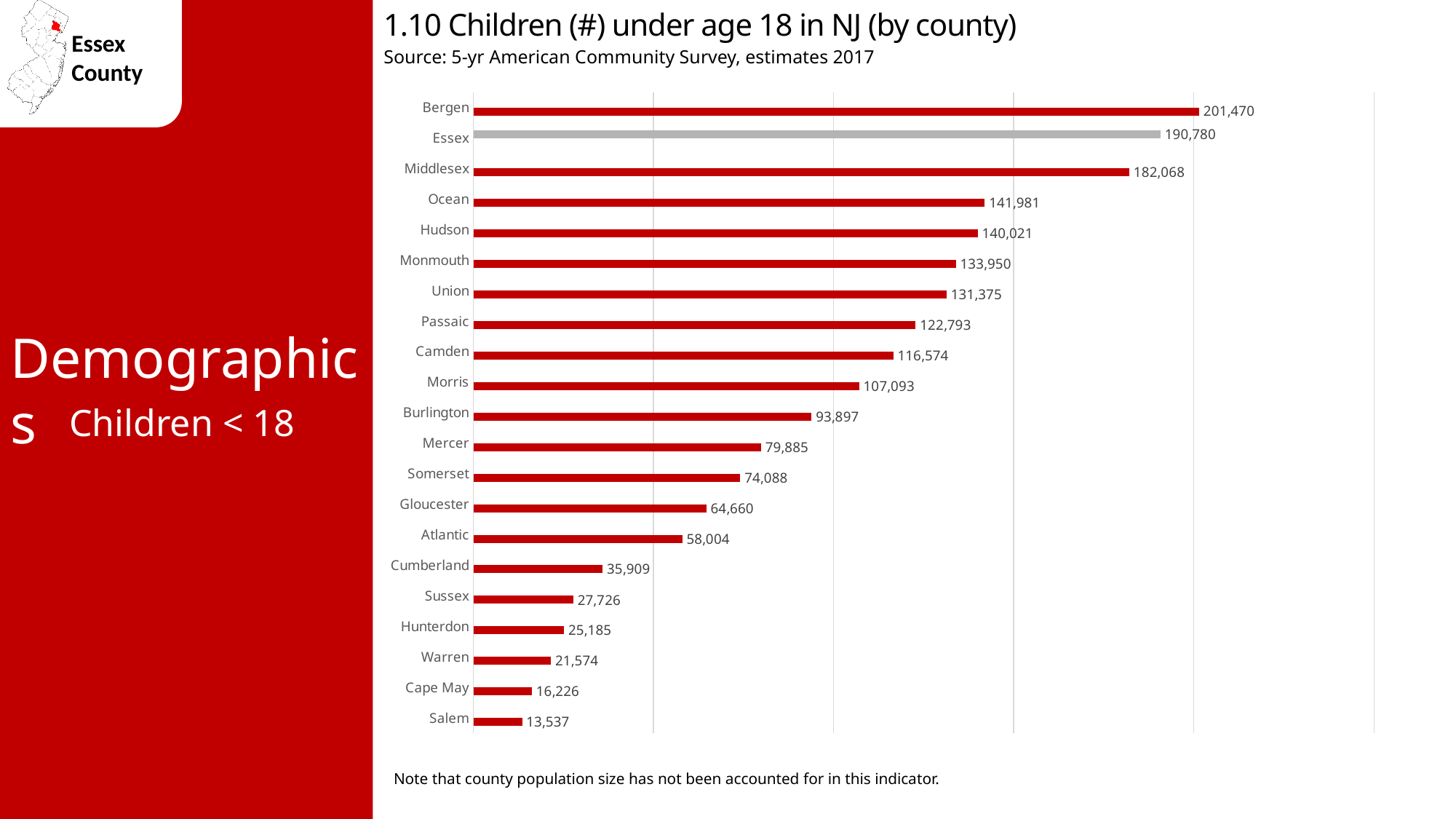
How many counties are shown in the chart? 21 How many children under age 18 are shown for Essex County? 190,780 Which county has more children under 18, Passaic or Camden? Passaic What is the difference between the values for Bergen and Essex? 10,690 What is the difference between the values for Middlesex and Ocean? 40,087 Which county has more children under 18, Sussex or Warren? Sussex Which county has the lowest number of children under age 18? Salem Which county's bar is shown in grey rather than red? Essex Which county has the highest number of children under age 18? Bergen What is the value shown for Cumberland County? 35,909 What type of chart is used on this slide? Bar chart What is the value shown for Morris County? 107,093